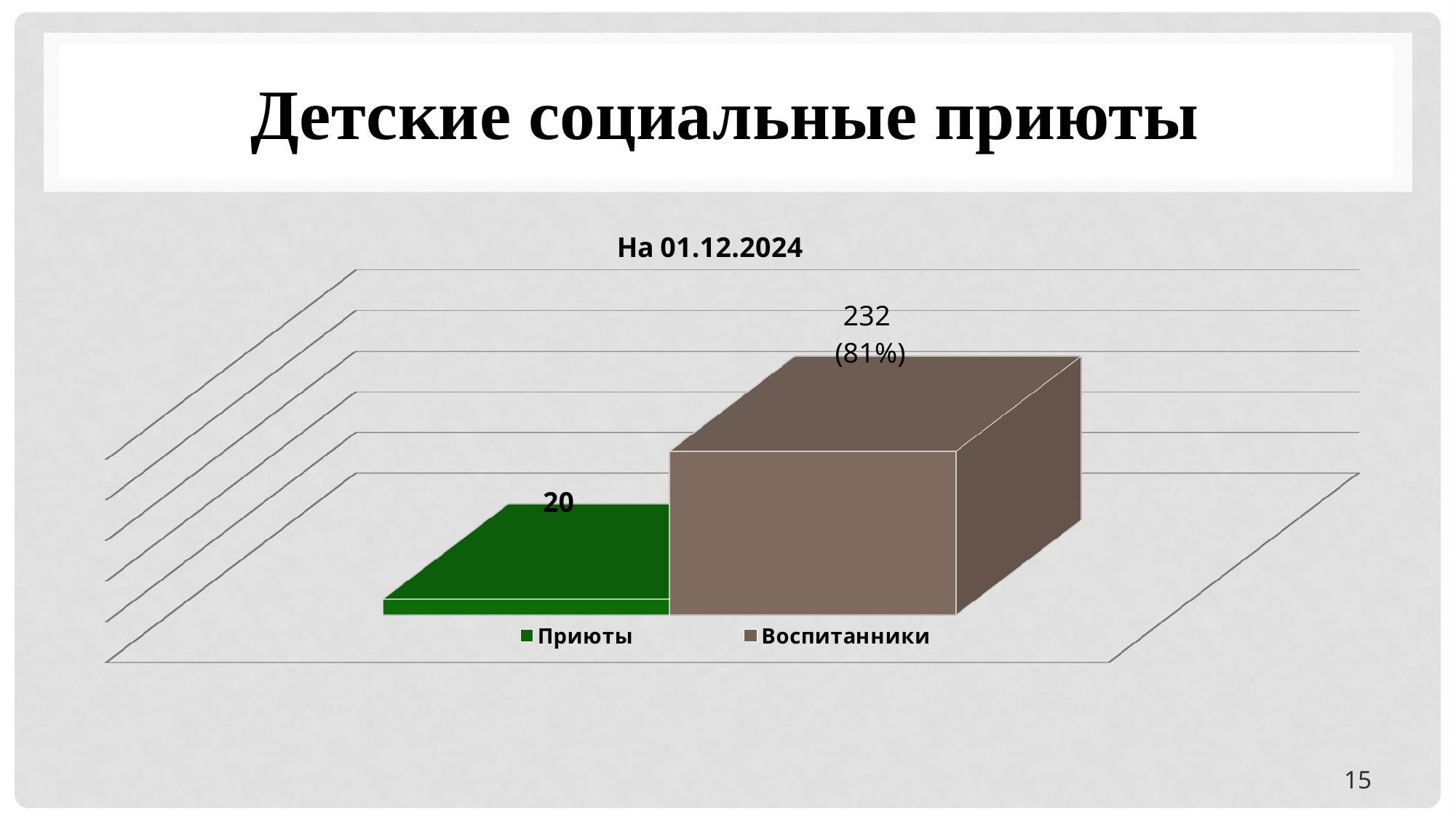
What is the difference between the values for Воспитанники and Приюты? 212 Which series has the higher value, Приюты or Воспитанники? Воспитанники What colour is the bar for Приюты? green How many series does the legend list? 2 Which series has the lowest value? Приюты What is the value for Воспитанники? 232 (81%) What is the title of the chart? На 01.12.2024 What kind of chart is shown on the slide? bar chart What is the value for Приюты? 20 What percentage is shown next to the value for Воспитанники? 81%